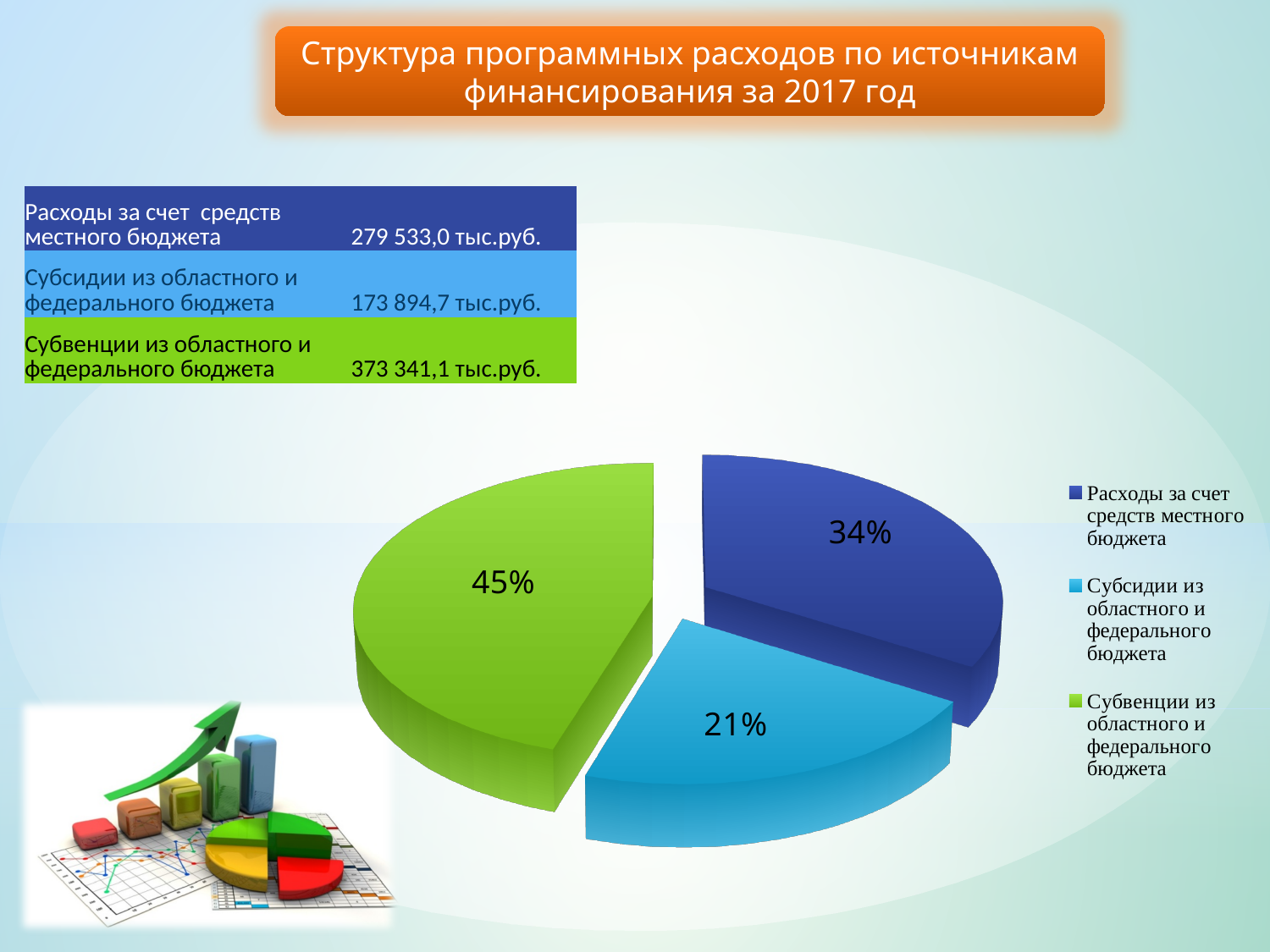
Which category has the largest slice of the pie? Субвенции из областного и федерального бюджета What share of the pie does "Субвенции из областного и федерального бюджета" have? 45% How many slices does the pie chart have? 3 What is the difference in percentage points between the slice for "Субвенции из областного и федерального бюджета" and the slice for "Субсидии из областного и федерального бюджета"? 24 How many entries does the legend list? 3 What is the title of the slide containing the pie chart? Структура программных расходов по источникам финансирования за 2017 год Which category has the smallest slice of the pie? Субсидии из областного и федерального бюджета What colour is the slice for "Субвенции из областного и федерального бюджета"? green What share of the pie does "Субсидии из областного и федерального бюджета" have? 21% What kind of chart is shown on the slide? pie chart What share of the pie does "Расходы за счет средств местного бюджета" have? 34% Which slice is larger: "Расходы за счет средств местного бюджета" or "Субсидии из областного и федерального бюджета"? Расходы за счет средств местного бюджета